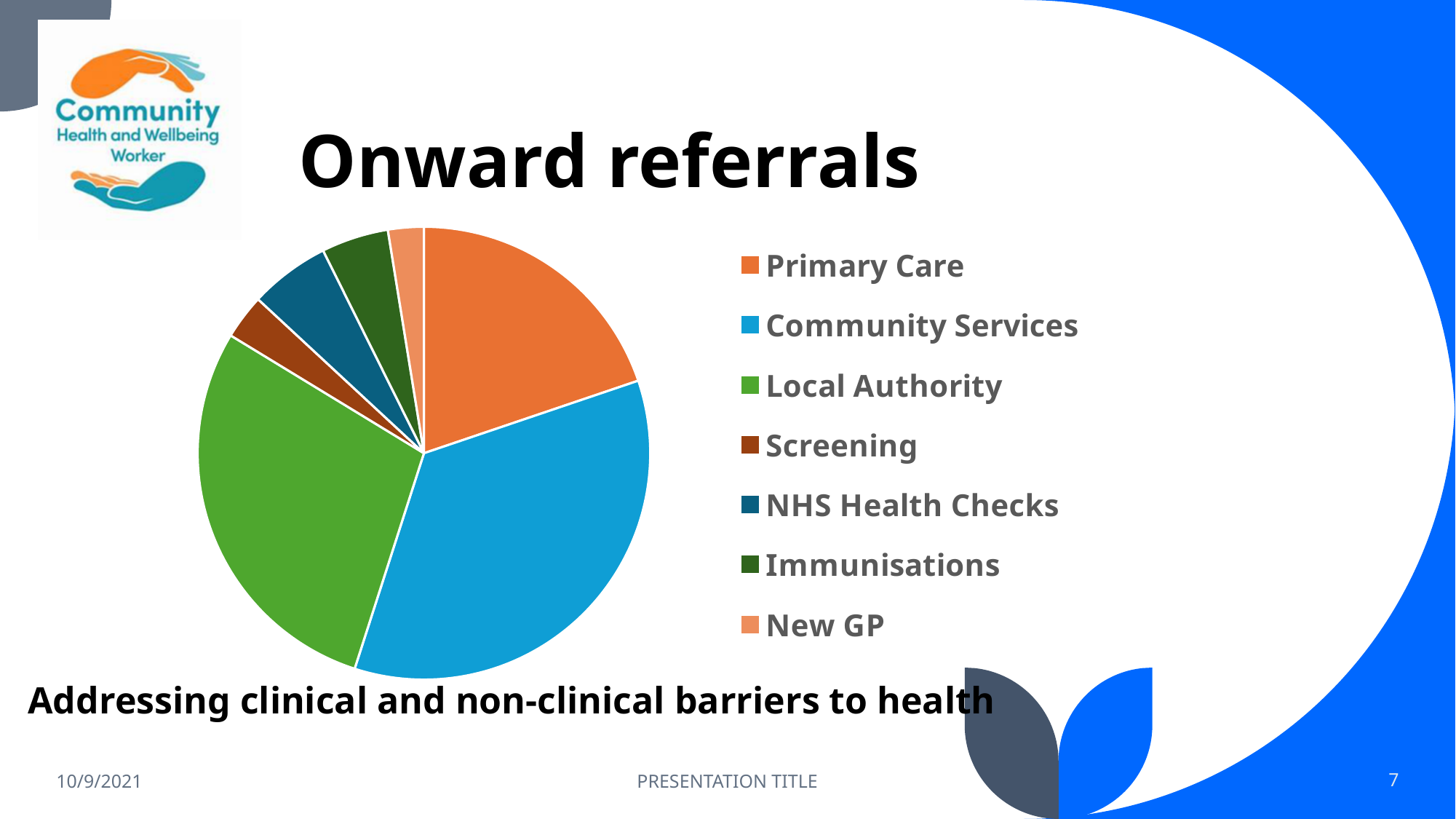
Which slice is larger, Local Authority or Immunisations? Local Authority What is the title of the chart on the slide? Onward referrals Which slice is larger, Community Services or Local Authority? Community Services What kind of chart is shown on the slide? pie chart Which category is shown in light blue on the pie chart? Community Services Which slice is larger, Community Services or Primary Care? Community Services How many categories does the pie chart's legend list? 7 Which category has the largest slice of the pie chart? Community Services